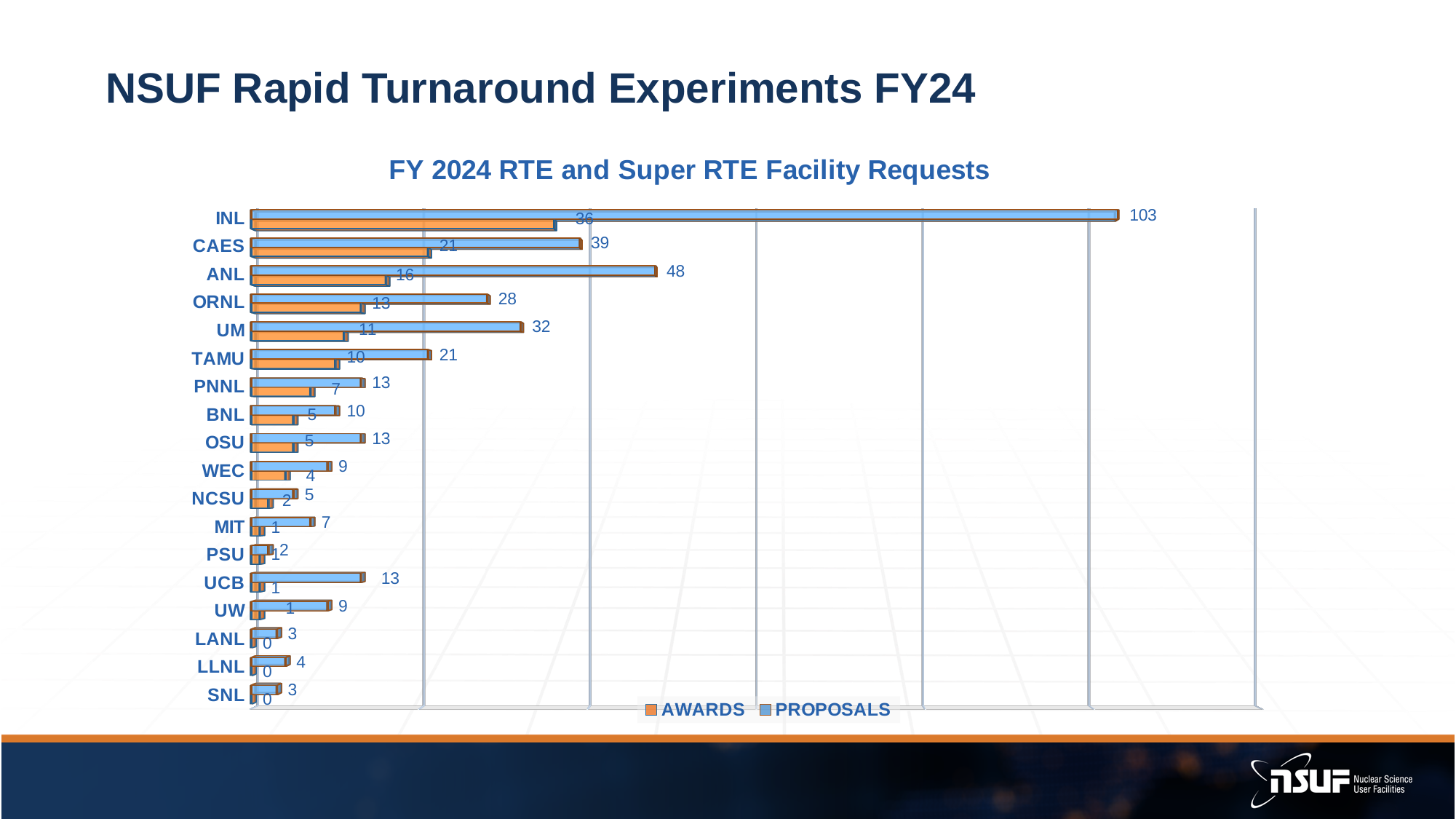
What is the number of PROPOSALS for ANL? 48 Which has more PROPOSALS, ANL or CAES? ANL What is the difference between PROPOSALS and AWARDS for INL? 67 Which facility has the lowest number of PROPOSALS? PSU What is the number of AWARDS for CAES? 21 What is the number of AWARDS for UM? 11 How many facilities are listed on the chart? 18 How many series does the legend list? 2 What kind of chart is shown on the slide? Bar chart Which facility has the highest number of PROPOSALS? INL What is the number of PROPOSALS for INL? 103 What is the title of the chart? FY 2024 RTE and Super RTE Facility Requests